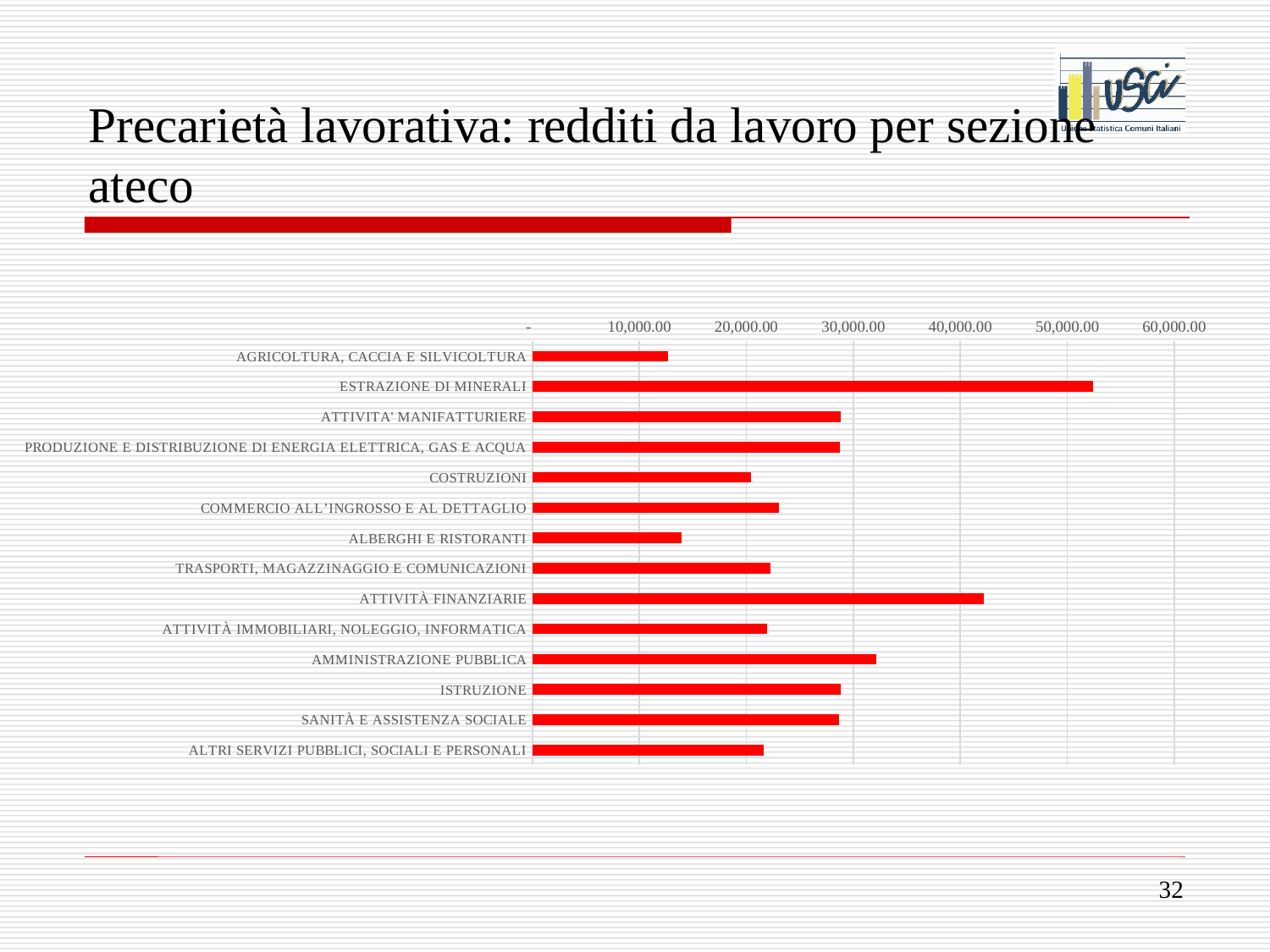
Is the value for AMMINISTRAZIONE PUBBLICA greater or less than 30,000.00? greater Is the value for ATTIVITA' MANIFATTURIERE greater or less than 30,000.00? less Which is larger, the value for AMMINISTRAZIONE PUBBLICA or the value for ALBERGHI E RISTORANTI? AMMINISTRAZIONE PUBBLICA How many categories (sezioni ateco) are plotted in the chart? 14 What is the title of the slide containing the chart? Precarietà lavorativa: redditi da lavoro per sezione ateco Which is larger, the value for ESTRAZIONE DI MINERALI or the value for ATTIVITÀ FINANZIARIE? ESTRAZIONE DI MINERALI Is the value for AGRICOLTURA, CACCIA E SILVICOLTURA greater or less than 10,000.00? greater What kind of chart is shown on the slide? Bar chart Which category has the highest value in the chart? ESTRAZIONE DI MINERALI